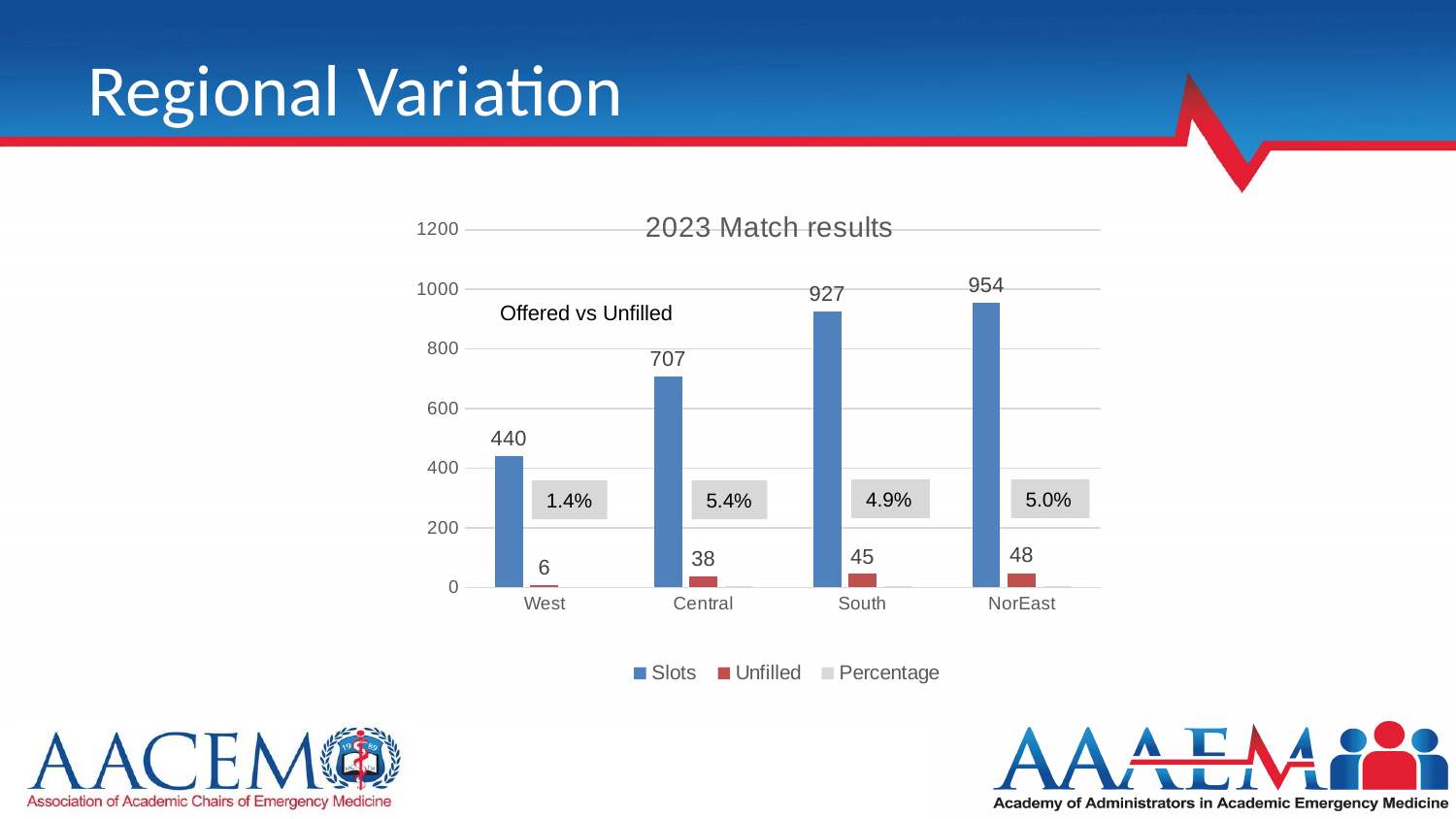
Is the Slots value for Central greater or less than 600? greater What is the Unfilled value for Central? 38 What Percentage is shown for the West region? 1.4% What is the difference in Slots between NorEast and West? 514 What type of chart is shown? Bar chart Which region has more Unfilled slots, South or Central? South How many series does the legend list? 3 How many regions are shown on the x axis? 4 Which region has the lowest Unfilled value? West Which region has the highest number of Slots? NorEast What is the number of Slots for the South region? 927 What is the title of the chart? 2023 Match results